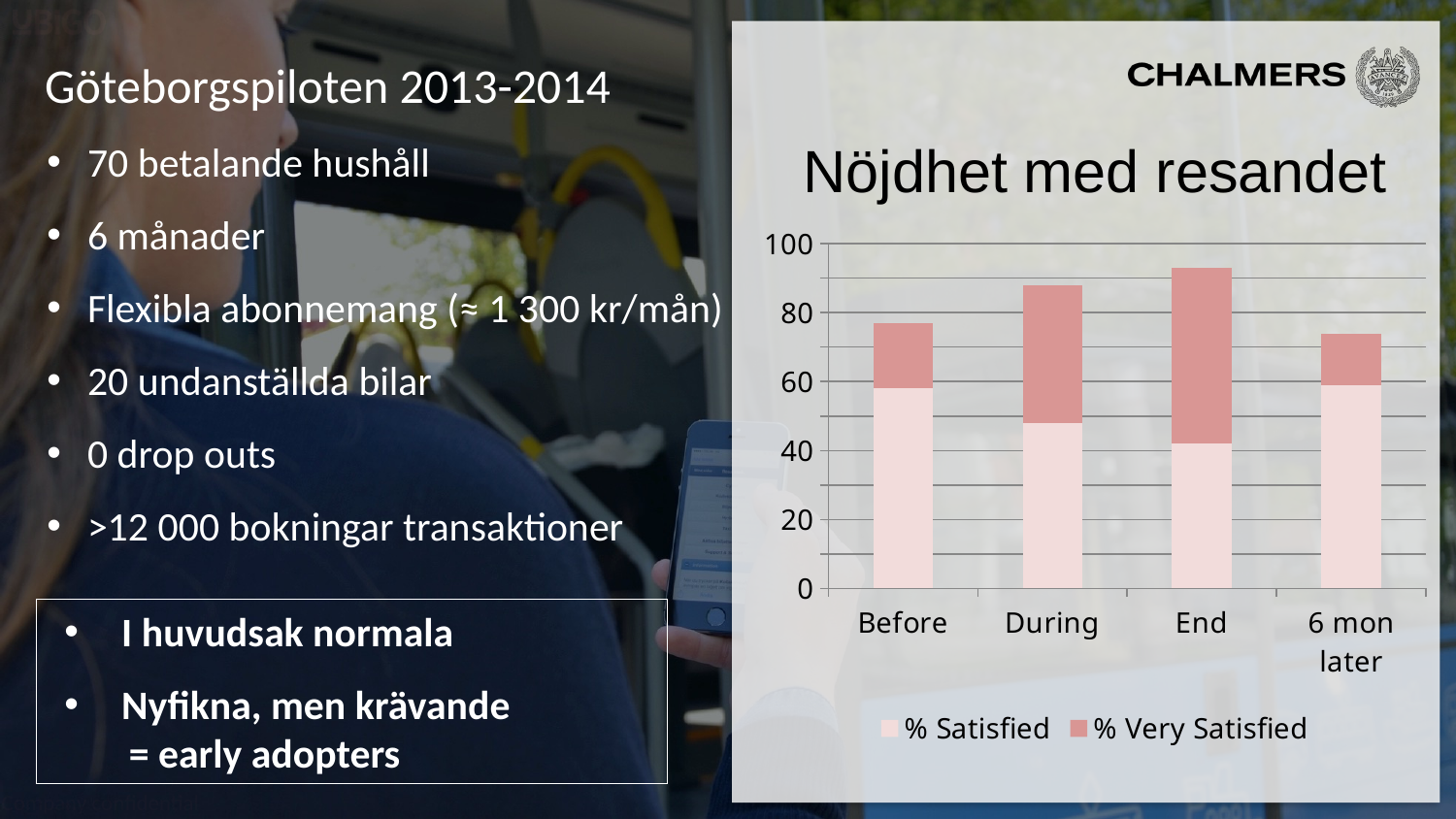
What is the title of the chart? Nöjdhet med resandet How many series does the chart's legend list? 2 Which category has the smallest % Satisfied segment? End Which category has the largest % Very Satisfied segment? End How many categories are shown on the x axis of the chart? 4 Which series are listed in the chart's legend? % Satisfied and % Very Satisfied Is the total height of the bar for During greater or less than 80? greater Is the total height of the bar for 6 mon later greater or less than 80? less What kind of chart is shown under the title "Nöjdhet med resandet"? stacked bar chart Is the % Satisfied value for End greater or less than 60? less Which category has the tallest stacked bar overall? End Which stacked bar is taller overall, End or Before? End